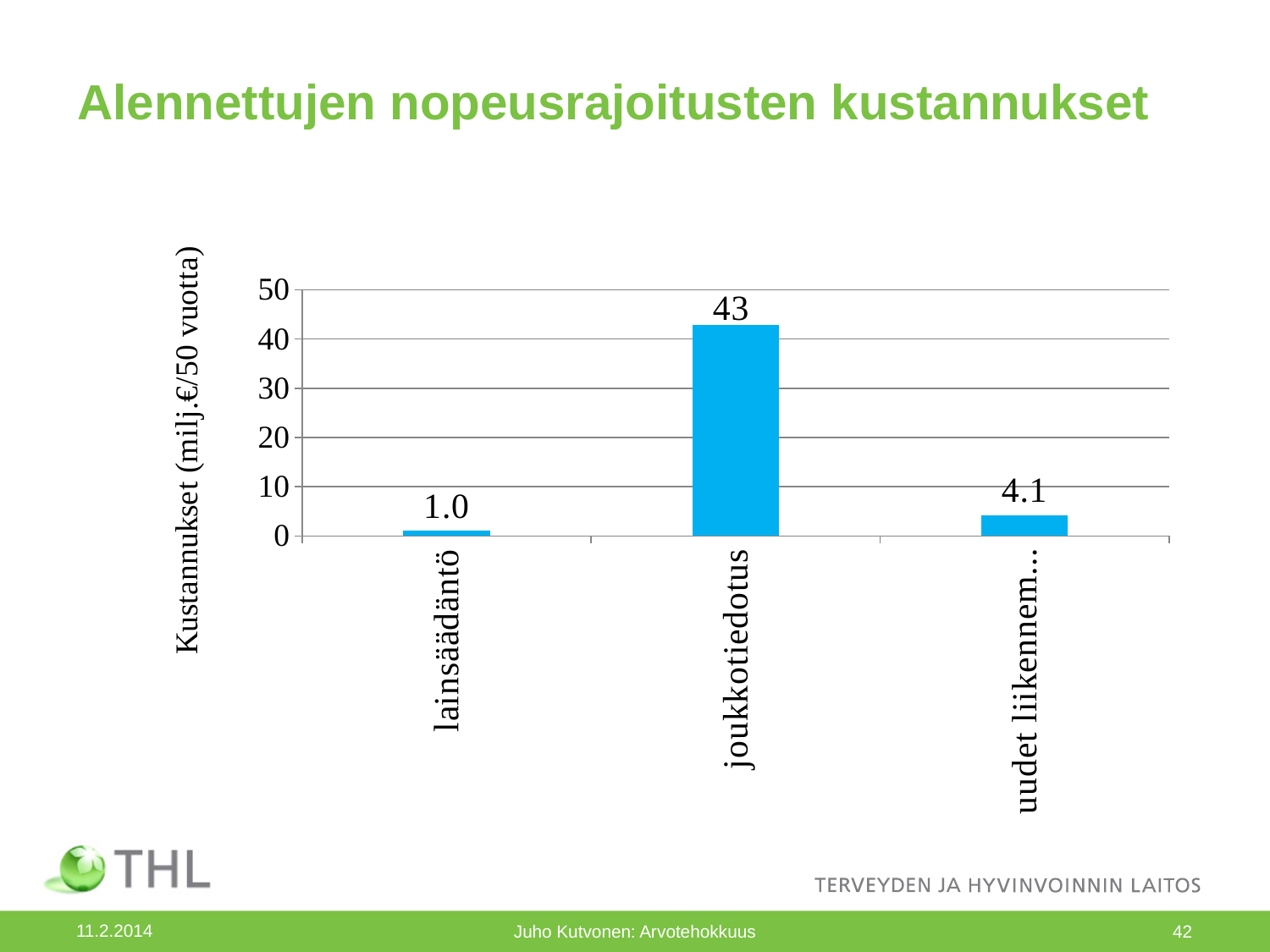
Which is larger, the value for joukkotiedotus or the value for the "uudet liikennem..." bar? joukkotiedotus What kind of chart is shown on the slide? bar chart Which category has the highest cost? joukkotiedotus What is the difference between the values for the "uudet liikennem..." bar and lainsäädäntö? 3.1 Is the value for joukkotiedotus greater or less than 40? greater What is the value for the third bar, labelled "uudet liikennem..."? 4.1 What is the difference between the values for joukkotiedotus and lainsäädäntö? 42 Which category has the lowest cost? lainsäädäntö What is the label of the vertical axis? Kustannukset (milj.€/50 vuotta) What is the value for joukkotiedotus? 43 What is the value for lainsäädäntö? 1.0 How many categories are shown in the chart? 3